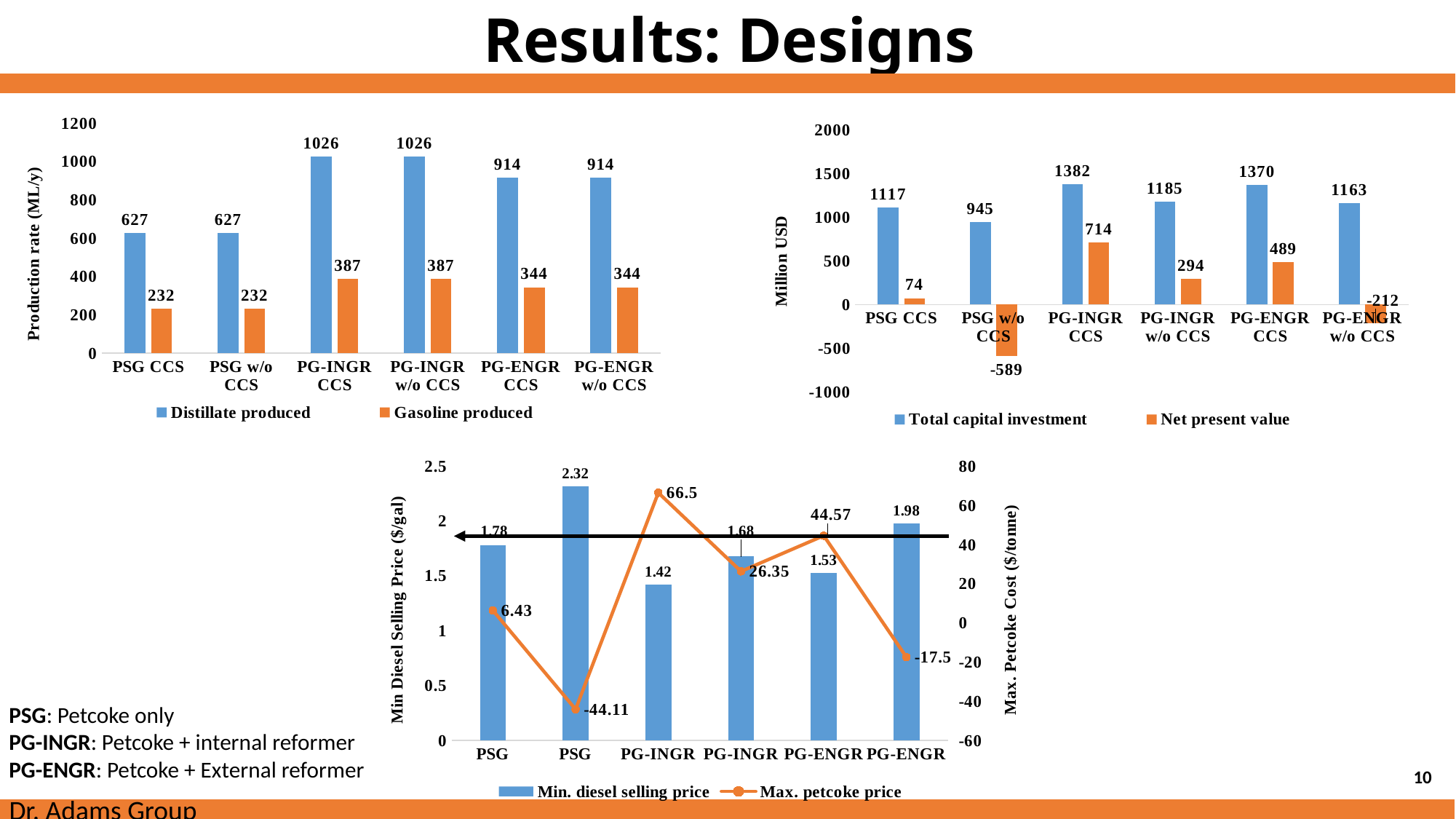
How many categories are shown on the x axis of the top-left chart? 6 In the top-right chart, which is larger: the Net present value for PG-INGR CCS or for PG-ENGR CCS? PG-INGR CCS In the top-right chart, what is the Net present value for PSG w/o CCS? -589 What kind of chart is the bottom chart? Combination bar and line chart In the bottom chart, what is the Min. diesel selling price for the second PSG bar? 2.32 In the top-right chart, what is the difference between the Total capital investment for PG-INGR CCS and PG-ENGR CCS? 12 In the top-left chart, what is the Gasoline produced value for PG-ENGR w/o CCS? 344 In the top-right chart, what is the Total capital investment for PG-INGR CCS? 1382 In the top-right chart, which category has the lowest Net present value? PSG w/o CCS In the top-left chart, what is the difference between Distillate produced and Gasoline produced for PSG CCS? 395 How many series does the legend of the top-left chart list? 2 In the top-left chart, what is the Distillate produced value for PG-INGR CCS? 1026